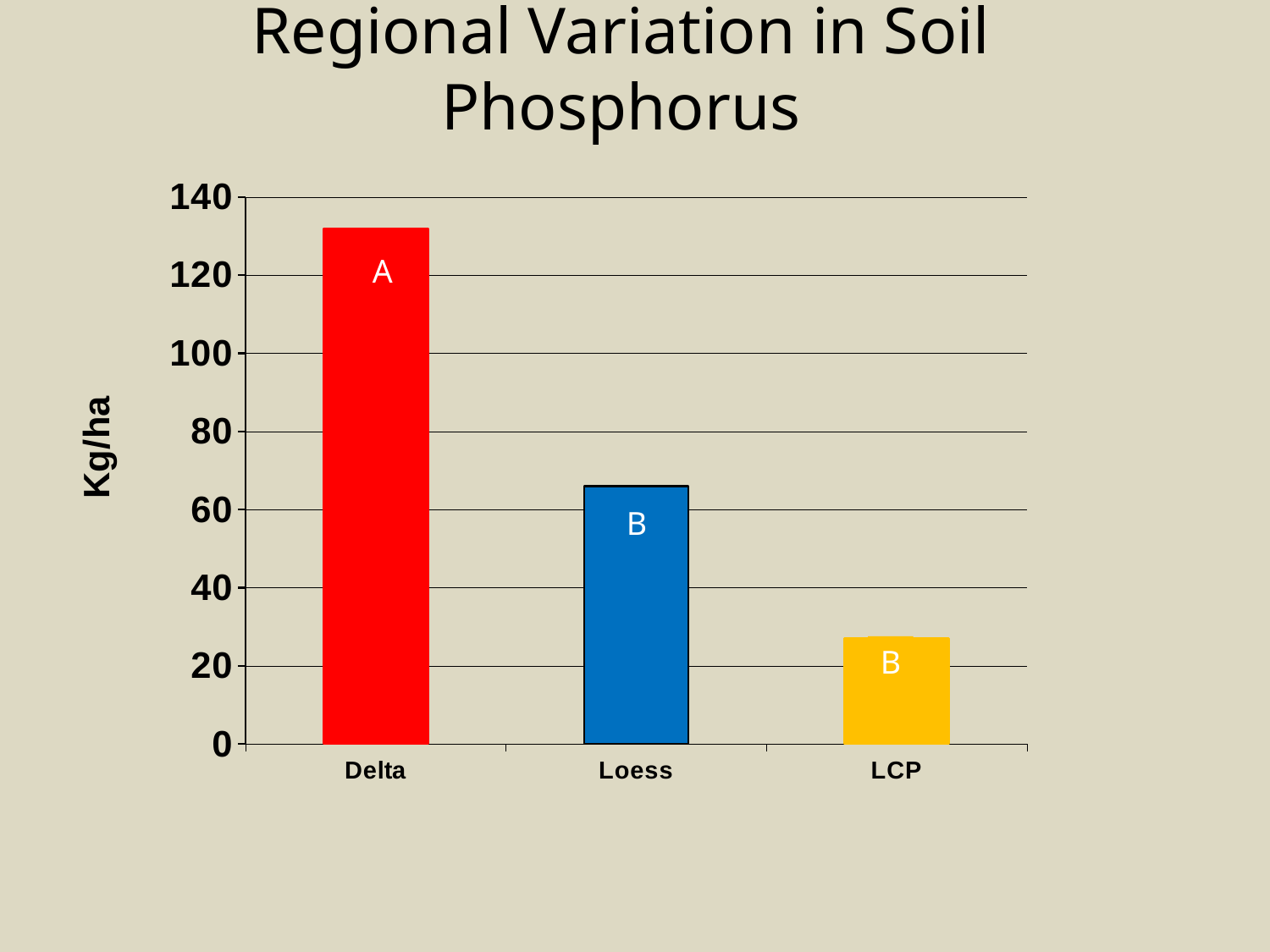
Is the value for Loess greater or less than 60? greater What kind of chart is shown on the slide? bar chart Is the value for Delta greater or less than 120? greater Do the values rise or fall from Delta to LCP along the x axis? fall How many regions are shown on the chart? 3 Is the value for LCP greater or less than 40? less Which region has the lowest soil phosphorus value? LCP Which has a larger value, Delta or Loess? Delta What unit is shown on the y axis of the chart? Kg/ha Which region has the highest soil phosphorus value? Delta Which has a larger value, Loess or LCP? Loess